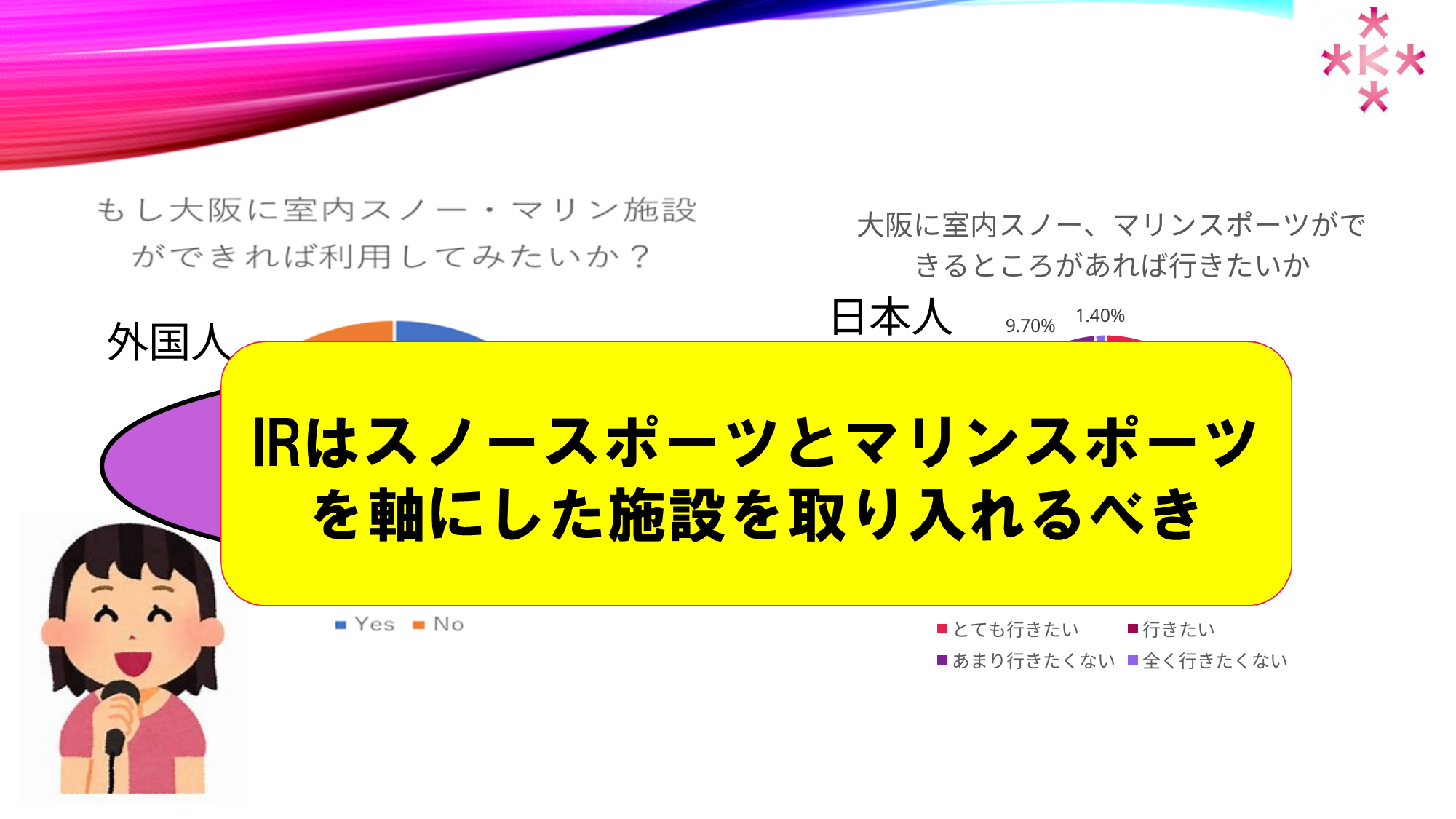
What are the two legend entries of the left chart (外国人)? Yes, No How many entries does the legend of the right chart (日本人) list? 4 What kind of chart is the right chart titled 「大阪に室内スノー、マリンスポーツができるところがあれば行きたいか」? Pie chart In the right chart (日本人), which is larger, あまり行きたくない or 全く行きたくない? あまり行きたくない What kind of chart is the left chart titled 「もし大阪に室内スノー・マリン施設ができれば利用してみたいか？」? Pie chart In the right chart (日本人), what percentage is shown for あまり行きたくない? 9.70% In the right chart (日本人), what percentage is shown for 全く行きたくない? 1.40% In the right chart (日本人), what is the difference between the あまり行きたくない and 全く行きたくない shares? 8.30% How many entries does the legend of the left chart (外国人) list? 2 Which group does the left chart represent, according to the label next to it? 外国人